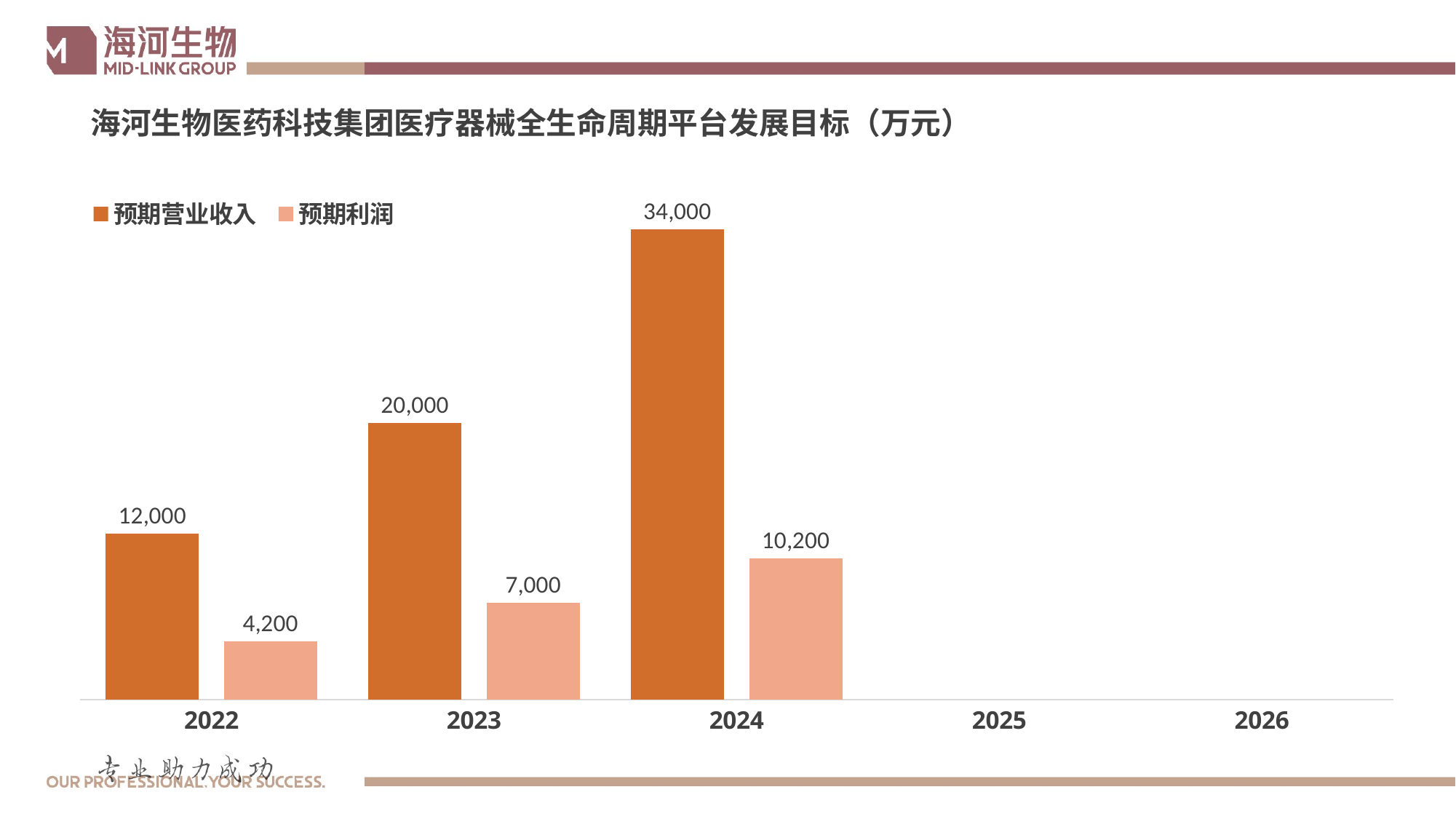
What is the difference in 预期营业收入 between 2024 and 2022? 22,000 Which year has the highest 预期营业收入? 2024 Does 预期营业收入 rise or fall from 2022 to 2024? Rise What is the 预期利润 value for 2022? 4,200 What is the 预期利润 value for 2023? 7,000 Which year has the lowest 预期利润 among the years with plotted bars? 2022 What is the 预期营业收入 value for 2022? 12,000 What kind of chart is shown on the slide? Bar chart Which is larger: 预期利润 in 2024 or 预期营业收入 in 2022? 预期营业收入 in 2022 What is the difference between 预期营业收入 and 预期利润 in 2023? 13,000 What is the 预期营业收入 value for 2024? 34,000 How many series does the legend list? 2